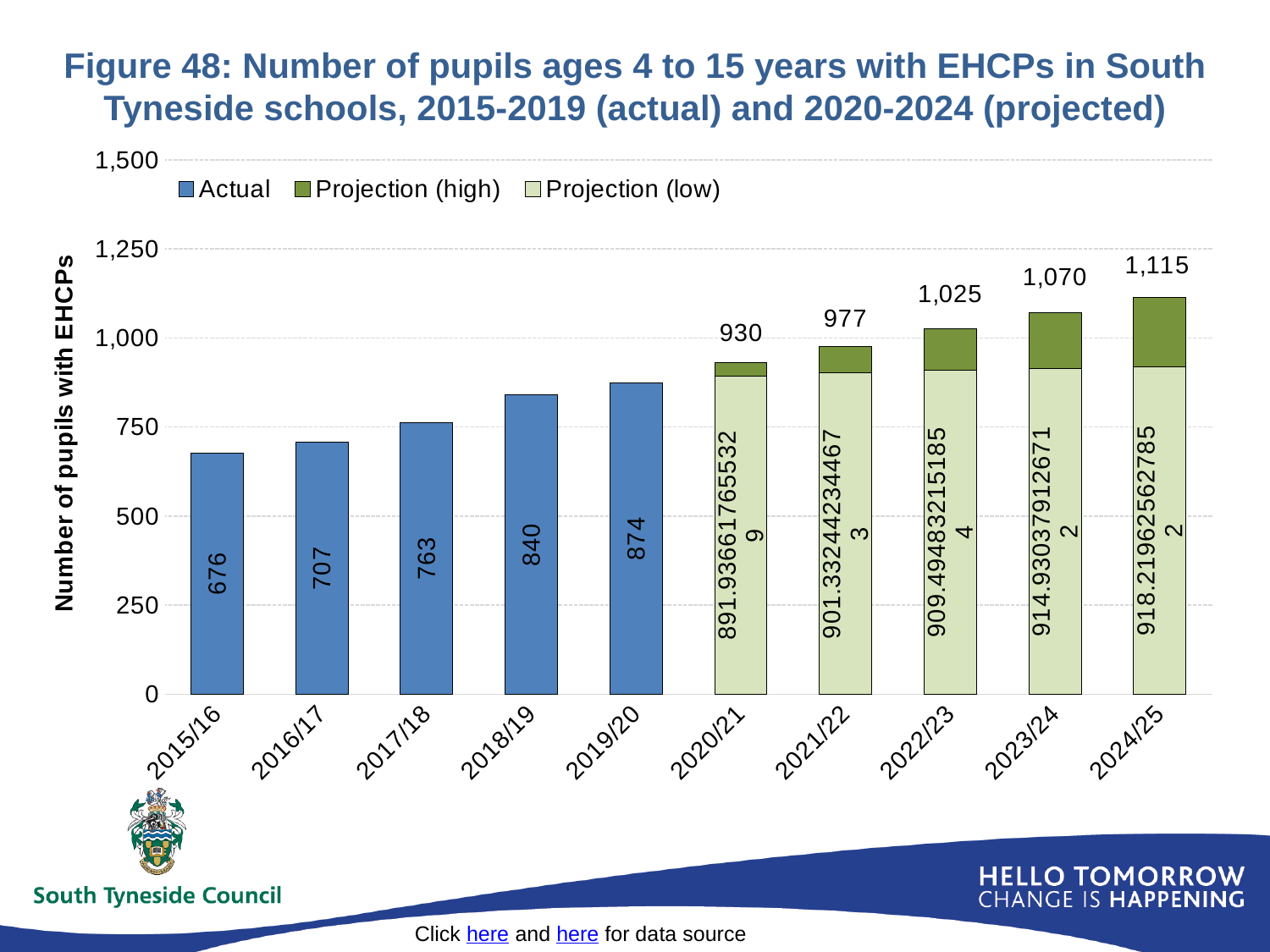
Do the values rise or fall from 2015/16 to 2024/25? rise Is the Projection (low) value for 2020/21 greater or less than 1,000? less What is the Projection (high) value shown for 2024/25? 1,115 What is the difference between the Actual values for 2018/19 and 2017/18? 77 How many academic years are shown on the x axis? 10 How many series does the legend list? 3 What is the Actual number of pupils with EHCPs in 2019/20? 874 What is the Projection (high) value shown for 2022/23? 1,025 Which year has the higher Actual value, 2016/17 or 2017/18? 2017/18 By how much did the Actual number of pupils with EHCPs increase from 2015/16 to 2019/20? 198 What is the Actual number of pupils with EHCPs in 2015/16? 676 Which year has the lowest Actual number of pupils with EHCPs? 2015/16